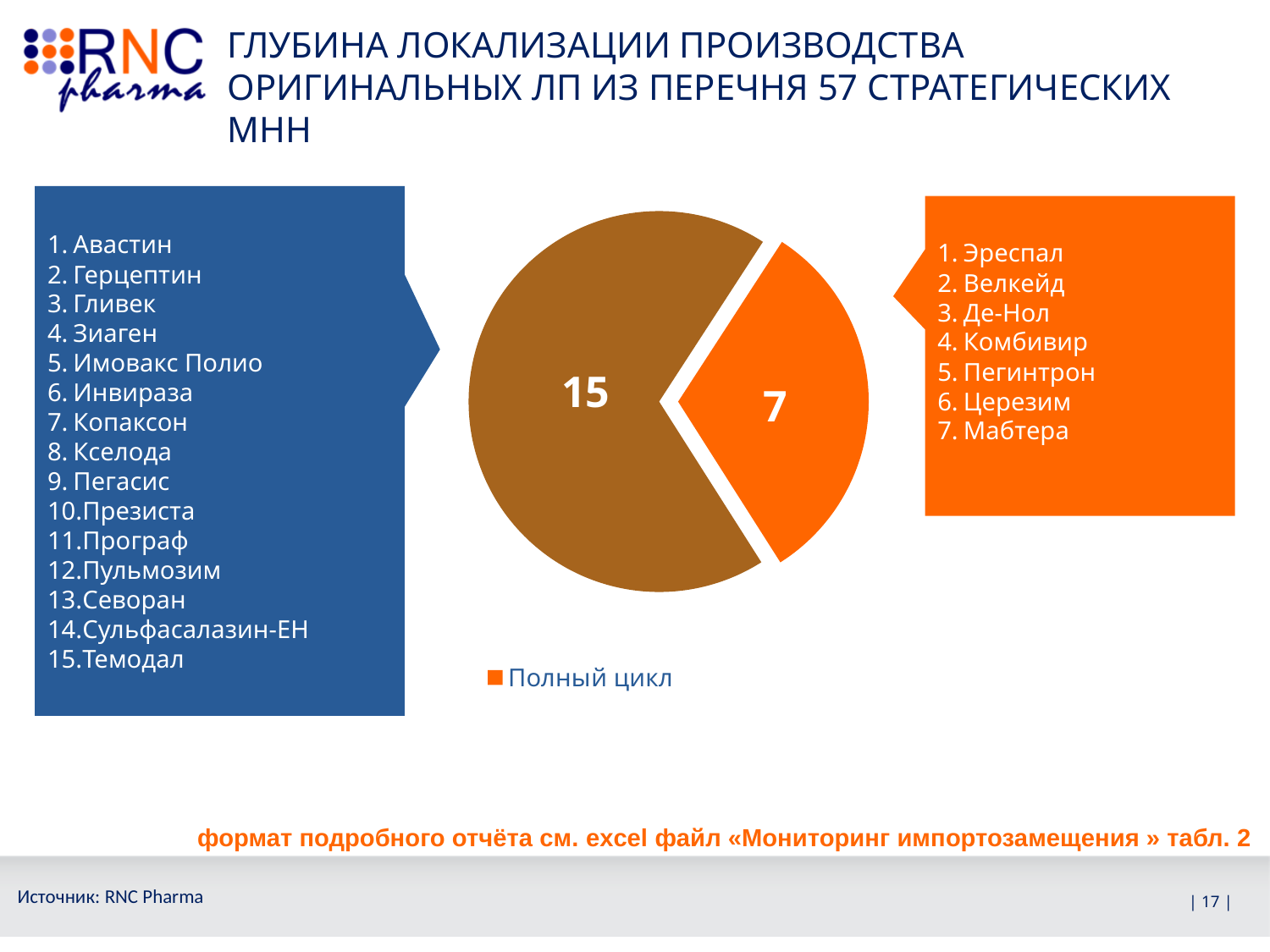
What is the total of the two values shown on the pie chart? 22 What is the value shown on the larger (brown) slice of the pie chart? 15 What is the only entry listed in the chart legend? Полный цикл What kind of chart is shown on the slide? pie chart How many slices does the pie chart have? 2 What colour is the "Полный цикл" slice in the pie chart? orange Which slice is larger: the orange "Полный цикл" slice or the brown slice? the brown slice What is the difference between the two slice values in the pie chart? 8 What is the smallest value shown on the pie chart? 7 What is the largest value shown on the pie chart? 15 What is the value of the "Полный цикл" slice in the pie chart? 7 How many entries does the chart legend list? 1